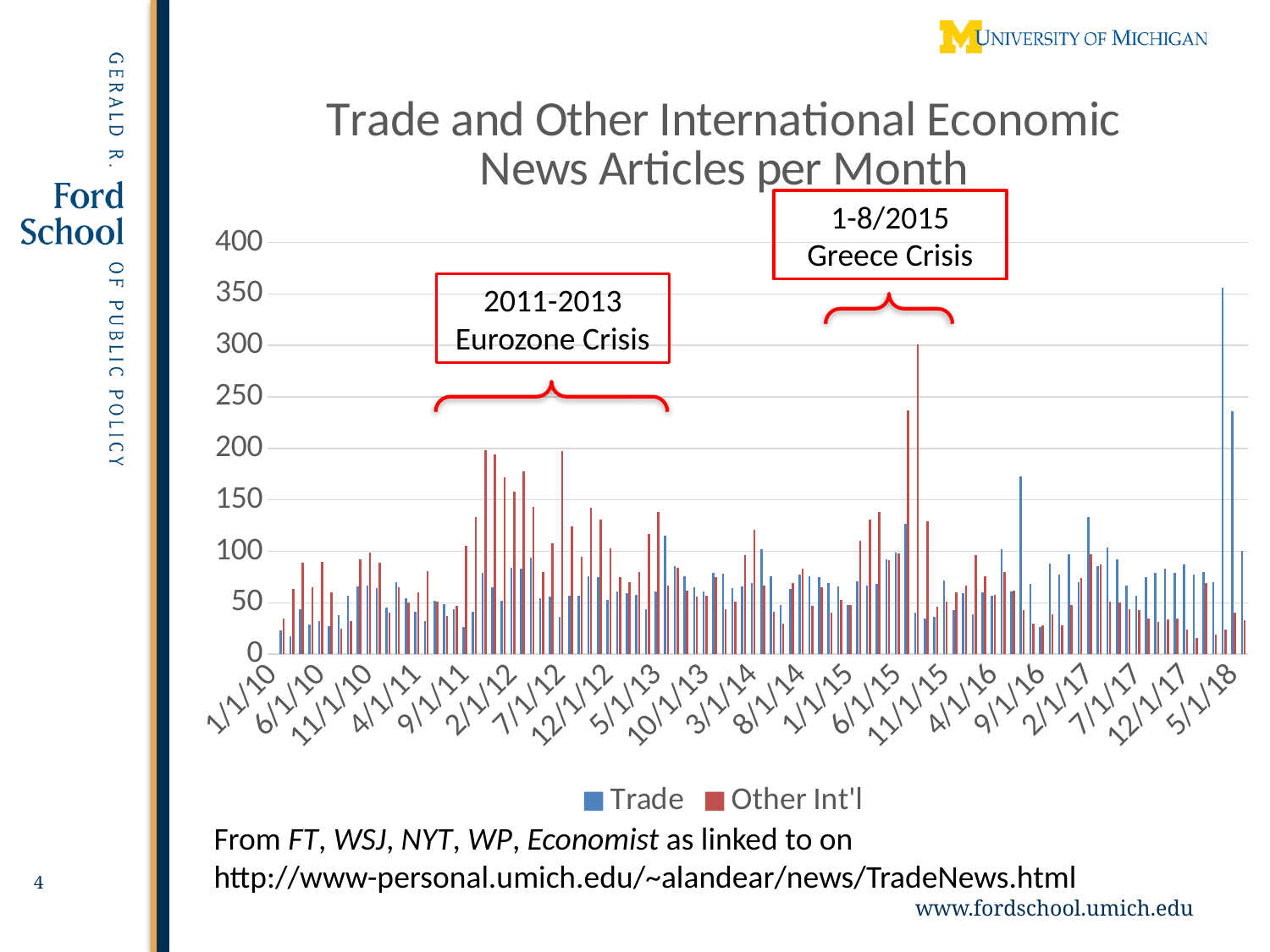
Is the tallest Trade bar, near 5/1/18, greater or less than 300? greater Is the Trade value at 1/1/10 greater or less than 50? less Which series contains the single tallest bar in the chart, Trade or Other Int'l? Trade Is the tallest Other Int'l bar, near 11/1/15, greater or less than 250? greater Which crisis does the annotation over 2011-2013 refer to? Eurozone Crisis How many series does the legend list? 2 Near 5/1/18, which series has the taller bar, Trade or Other Int'l? Trade What kind of chart is shown on the slide? bar chart Near 11/1/15, which series has the taller bar, Trade or Other Int'l? Other Int'l What are the two series named in the legend? Trade and Other Int'l